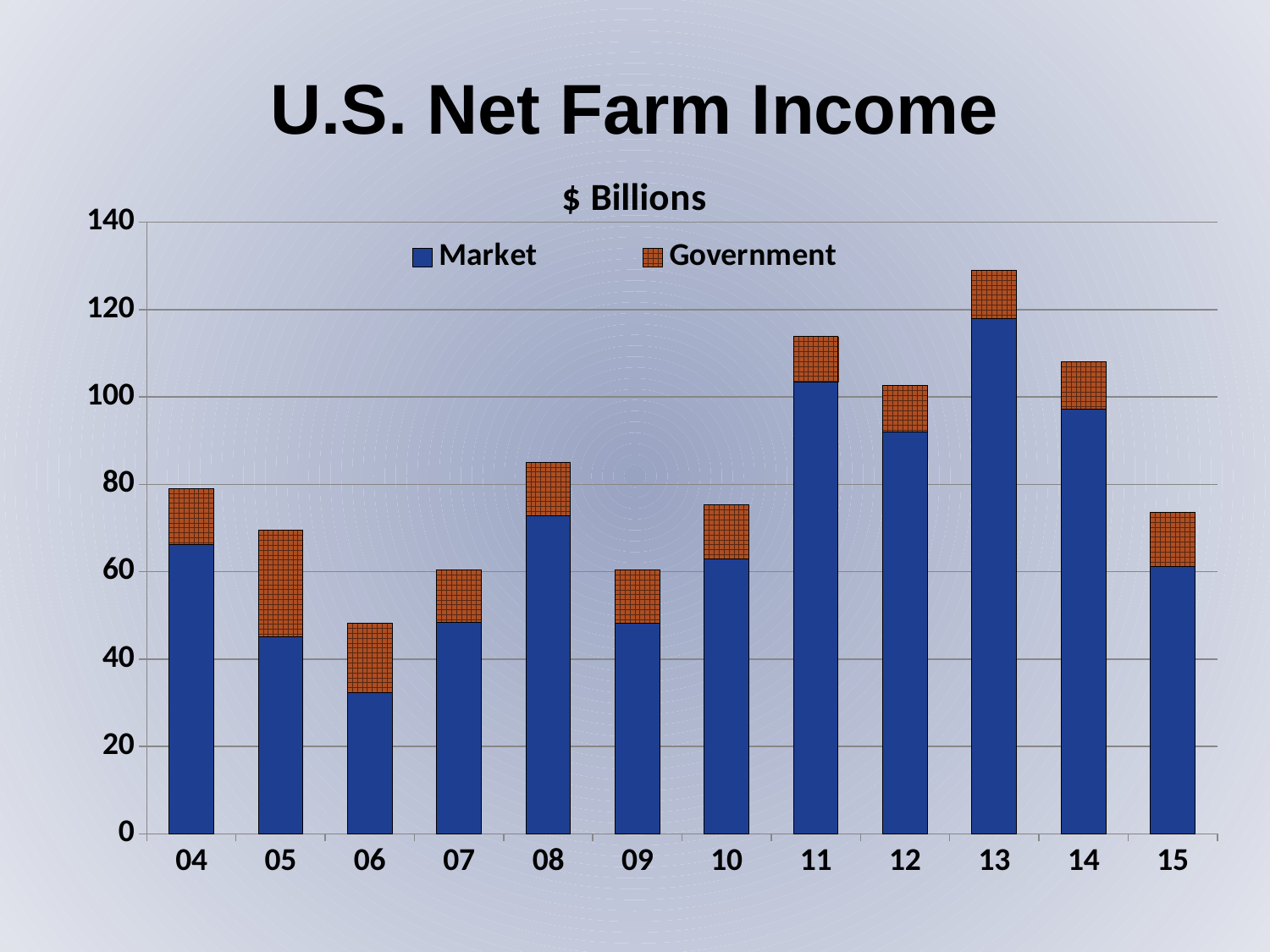
How many series does the legend list? 2 Which year has the larger total net farm income, 11 or 12? 11 Which series is shown in blue in the legend? Market How many years are shown on the x axis? 12 Do the total values rise or fall from 06 to 08? rise Which year has the lowest total net farm income? 06 Which year has the highest total net farm income? 13 Is the Market value for 05 greater or less than 60? less Is the total value for 06 greater or less than 60? less Is the total value for 11 greater or less than 100? greater What kind of chart is shown on the slide? Stacked bar chart